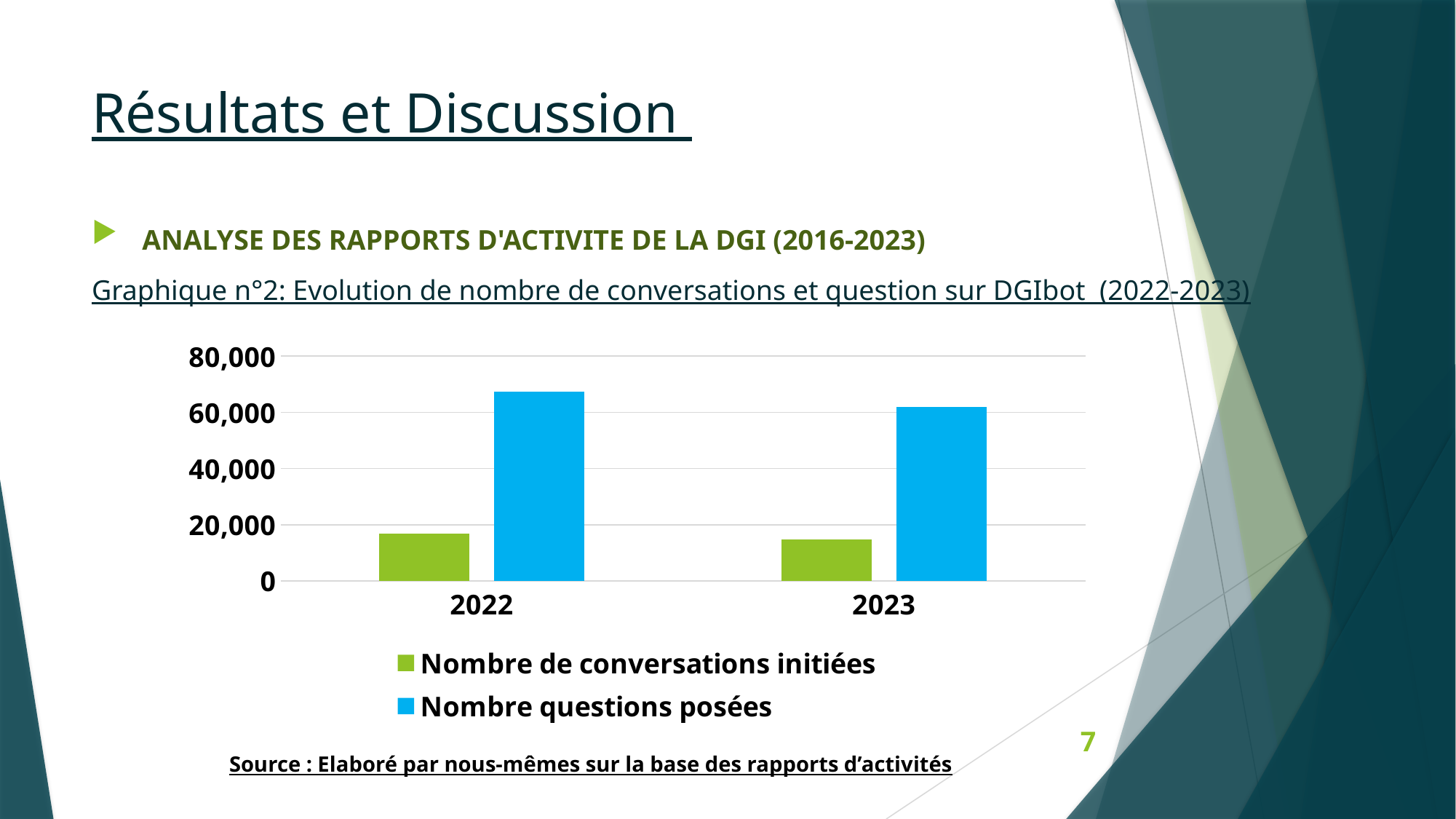
What kind of chart is shown on the slide? bar chart How many series does the legend list? 2 In 2022, which series has the larger value, Nombre de conversations initiées or Nombre questions posées? Nombre questions posées Which year has the higher value for Nombre questions posées, 2022 or 2023? 2022 Which colour represents Nombre de conversations initiées in the legend? green Is the value for Nombre de conversations initiées in 2022 greater or less than 20,000? less Does the value for Nombre questions posées rise or fall from 2022 to 2023? fall How many years are shown on the x axis? 2 What is the title of the chart (Graphique n°2)? Evolution de nombre de conversations et question sur DGIbot (2022-2023) Is the value for Nombre de conversations initiées in 2023 greater or less than 20,000? less Is the value for Nombre questions posées in 2022 greater or less than 60,000? greater